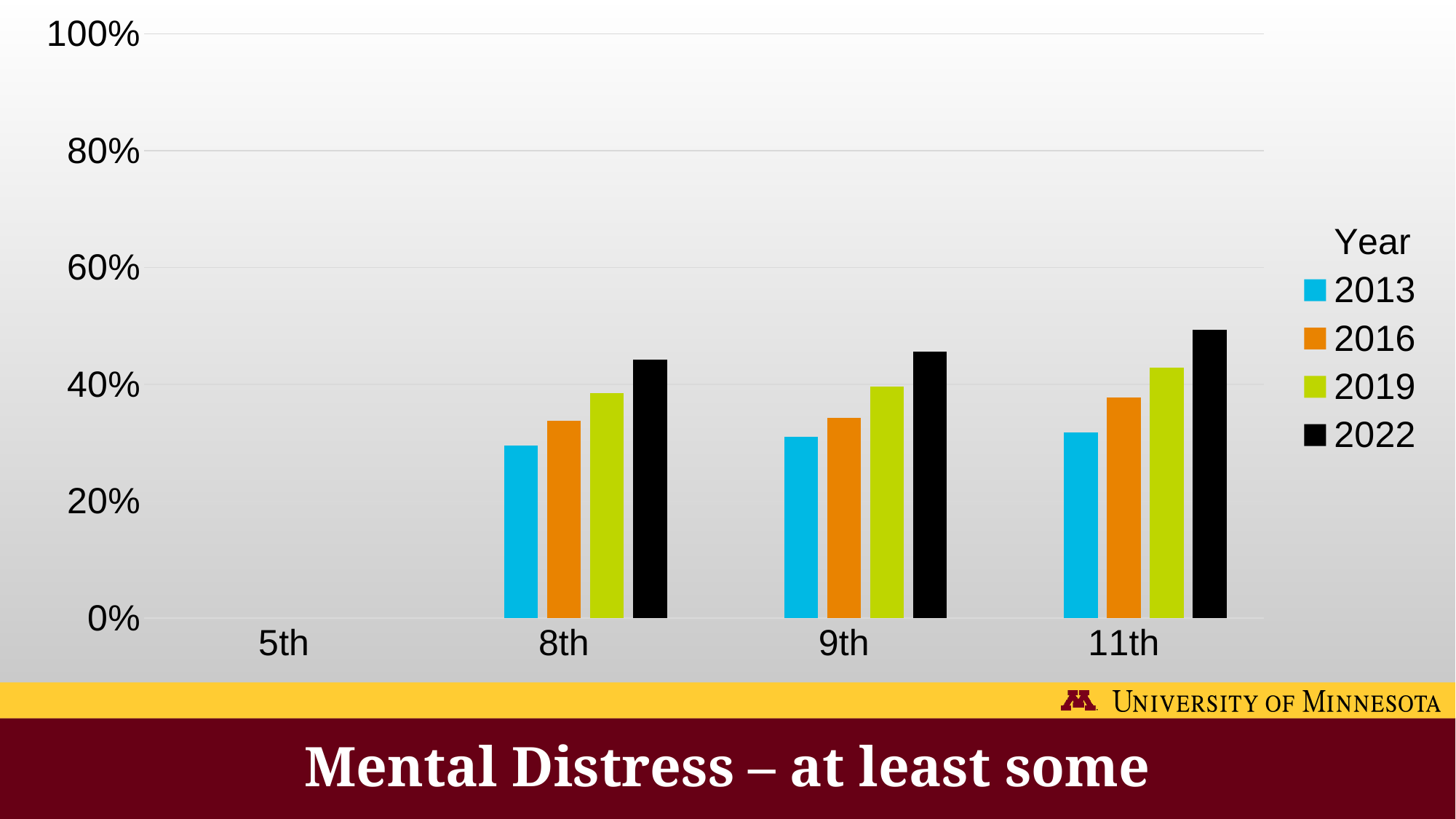
Within each grade, do the values rise or fall from 2013 to 2022? rise How many series does the legend list? 4 Is the value for 2013 for 8th grade greater or less than 40%? less Is the value for 2022 for 9th grade greater or less than 60%? less What is the title of the legend? Year Which year has the highest value for 11th grade? 2022 For 9th grade, which is larger: the value for 2013 or the value for 2022? 2022 Which grade has the highest value for 2022? 11th Is the value for 2022 for 11th grade greater or less than 40%? greater Which year has the lowest value for 8th grade? 2013 How many grade categories are shown on the x axis? 4 What kind of chart is shown on the slide? bar chart